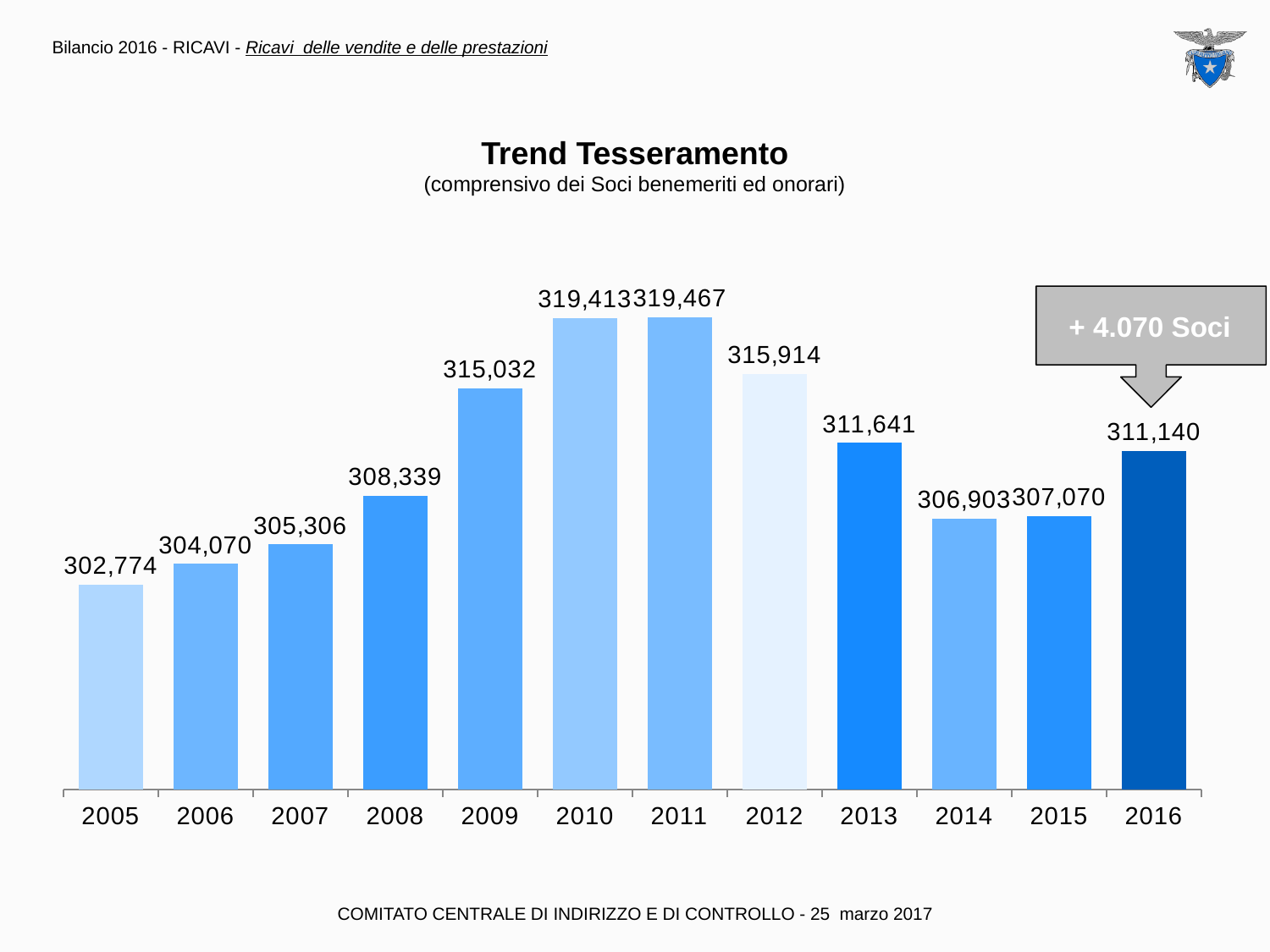
What is the title of the chart? Trend Tesseramento What is the difference between the values for 2016 and 2015? 4,070 What is the value for 2012? 315,914 What is the value for 2011? 319,467 What kind of chart is shown on the slide? Bar chart What is the difference between the values for 2013 and 2014? 4,738 How many years are shown on the x axis? 12 Do the values rise or fall from 2005 to 2011? Rise Which year has the lowest value? 2005 Which is larger, the value for 2008 or the value for 2013? 2013 What is the value for 2016? 311,140 What is the value for 2005? 302,774